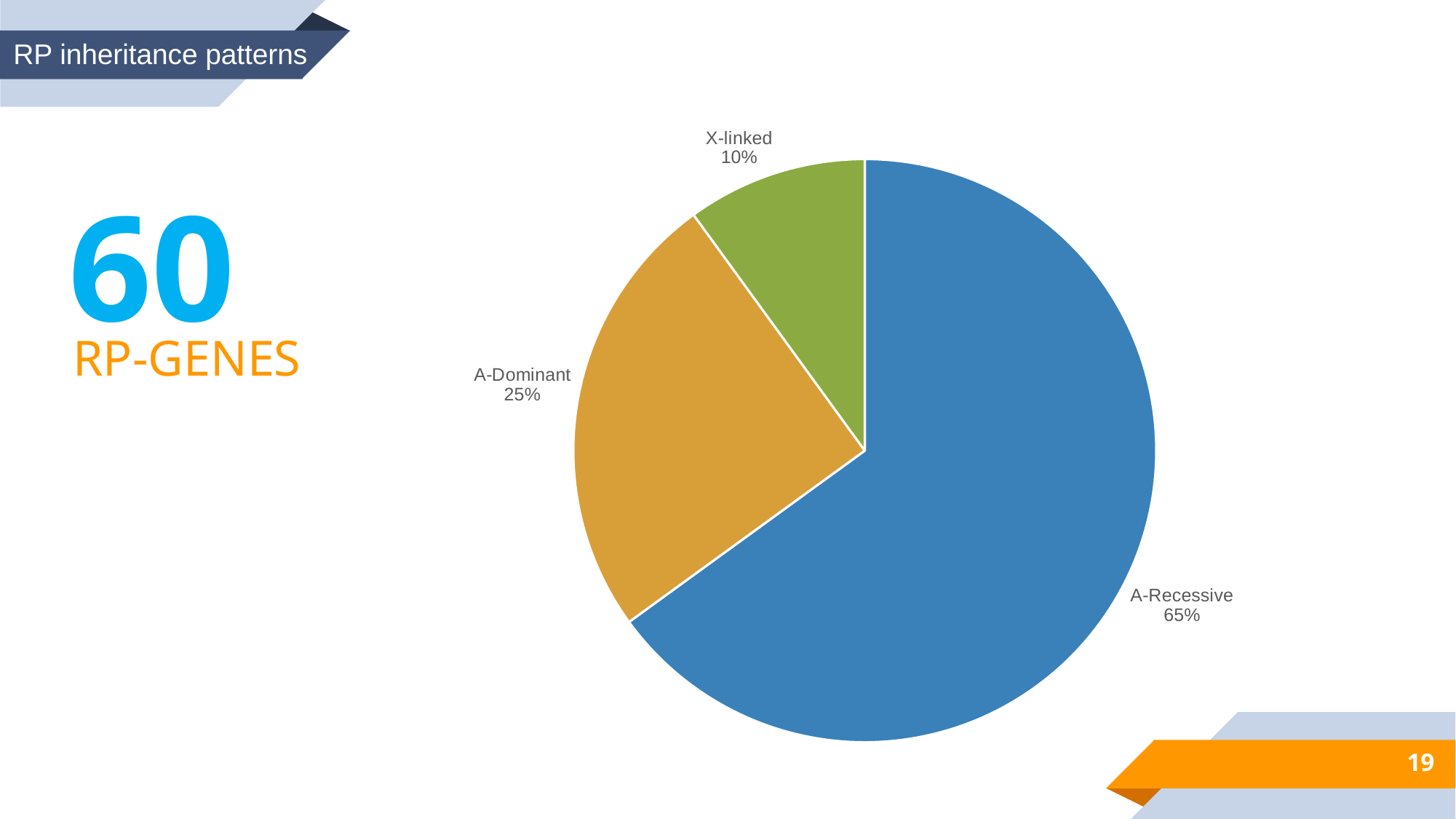
What percentage of the pie is A-Recessive? 65% What is the difference in percentage points between A-Recessive and A-Dominant? 40 Which inheritance pattern has the largest slice of the pie? A-Recessive What is the difference in percentage points between A-Dominant and X-linked? 15 How many slices does the pie chart have? 3 What percentage of the pie is A-Dominant? 25% Which inheritance pattern has the smallest slice of the pie? X-linked Which is larger, the A-Dominant slice or the X-linked slice? A-Dominant What percentage of the pie is X-linked? 10% What colour is the A-Recessive slice? blue What kind of chart is shown on the slide? pie chart What colour is the X-linked slice? green